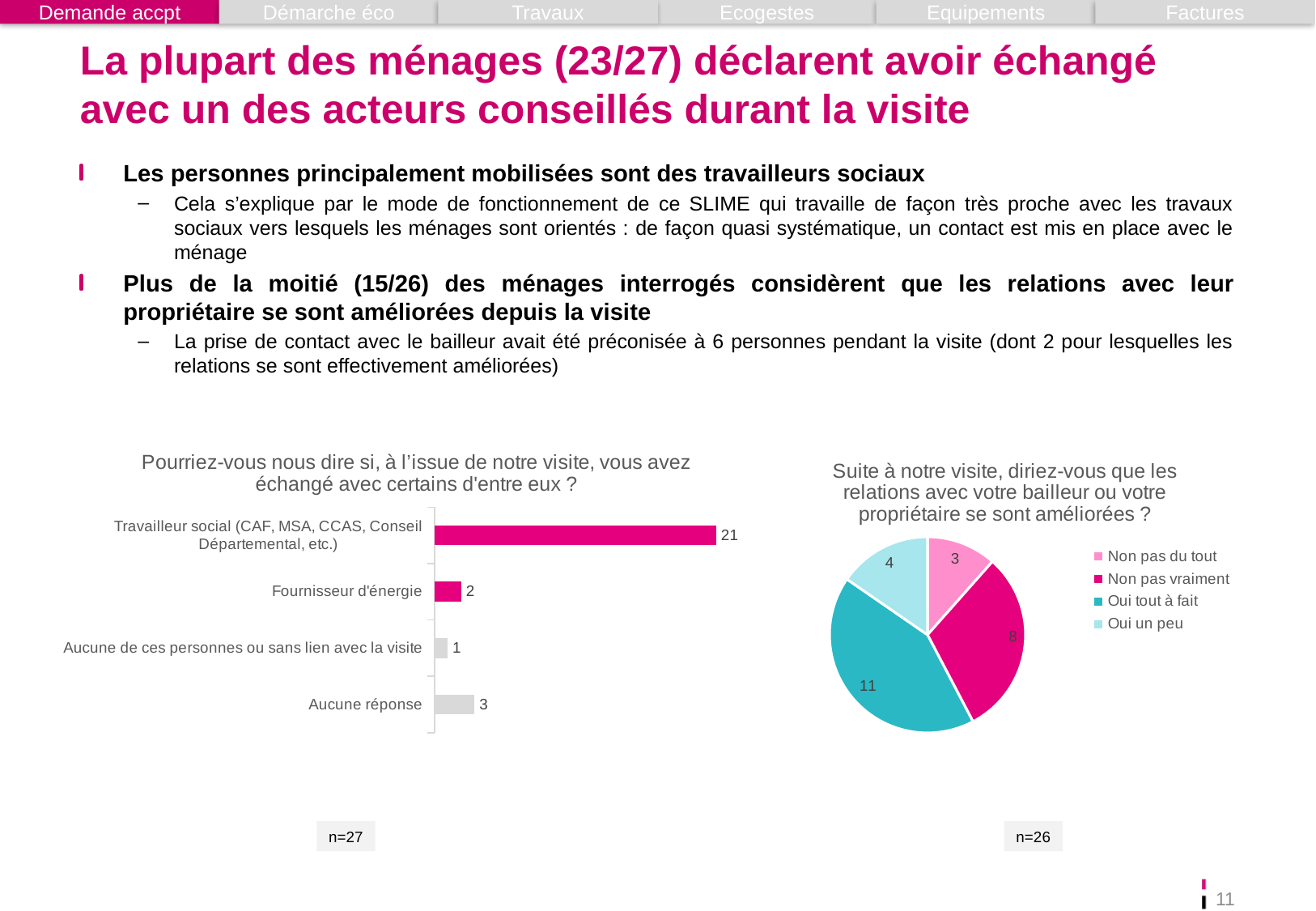
In the left bar chart, what is the value for 'Fournisseur d'énergie'? 2 In the left bar chart, which category has the highest value? Travailleur social (CAF, MSA, CCAS, Conseil Départemental, etc.) In the pie chart on the right, what is the value for 'Oui tout à fait'? 11 In the left bar chart, what is the difference between the values for 'Travailleur social' and 'Aucune réponse'? 18 In the pie chart on the right, which category has the smallest slice? Non pas du tout In the left bar chart, which category has the lowest value? Aucune de ces personnes ou sans lien avec la visite In the pie chart on the right, what is the value for 'Non pas vraiment'? 8 In the left bar chart, what is the value for 'Travailleur social (CAF, MSA, CCAS, Conseil Départemental, etc.)'? 21 In the left bar chart, how many categories are shown? 4 How many entries does the legend of the pie chart on the right list? 4 What type of chart is the chart on the left of the slide? Bar chart In the pie chart on the right, which is larger: 'Oui un peu' or 'Non pas vraiment'? Non pas vraiment